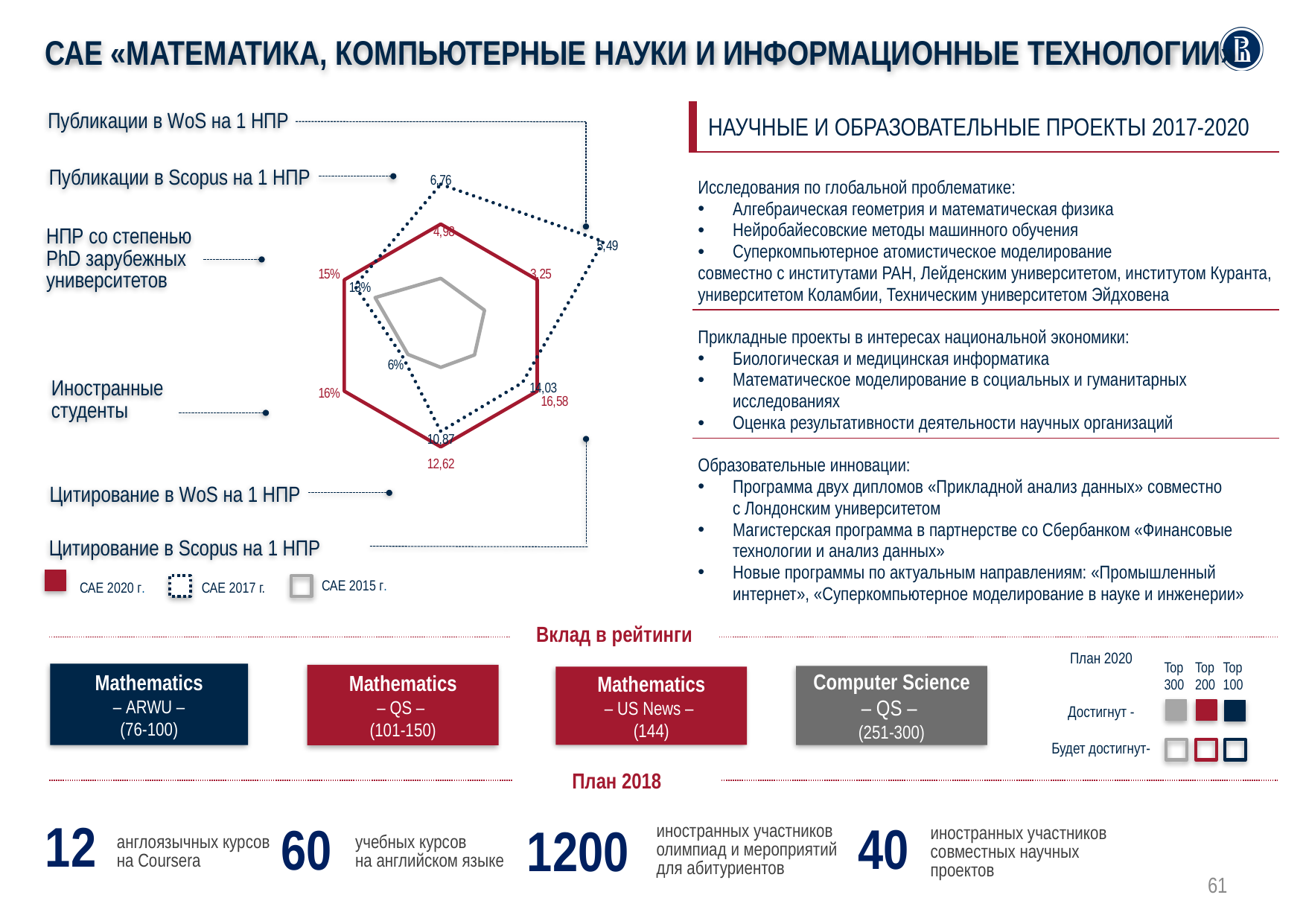
What is the value for Публикации в WoS на 1 НПР for САЕ 2017 г.? 5,49 What is the value for Иностранные студенты for САЕ 2020 г.? 16% What is the value for Публикации в Scopus на 1 НПР for САЕ 2020 г.? 4,98 What is the value for Цитирование в Scopus на 1 НПР for САЕ 2020 г.? 16,58 What is the difference between the САЕ 2020 г. and САЕ 2017 г. values for Иностранные студенты? 10% How many series does the legend of the radar chart list? 3 Which legend entry is drawn with a dotted line in the radar chart? САЕ 2017 г. How many axes (indicators) does the radar chart have? 6 Which series has the larger value for Цитирование в WoS на 1 НПР, САЕ 2020 г. or САЕ 2017 г.? САЕ 2020 г. What is the difference between the САЕ 2017 г. and САЕ 2020 г. values for Публикации в WoS на 1 НПР? 2,24 What kind of chart is shown on the left of the slide? radar chart What is the value for Публикации в Scopus на 1 НПР for САЕ 2017 г.? 6,76